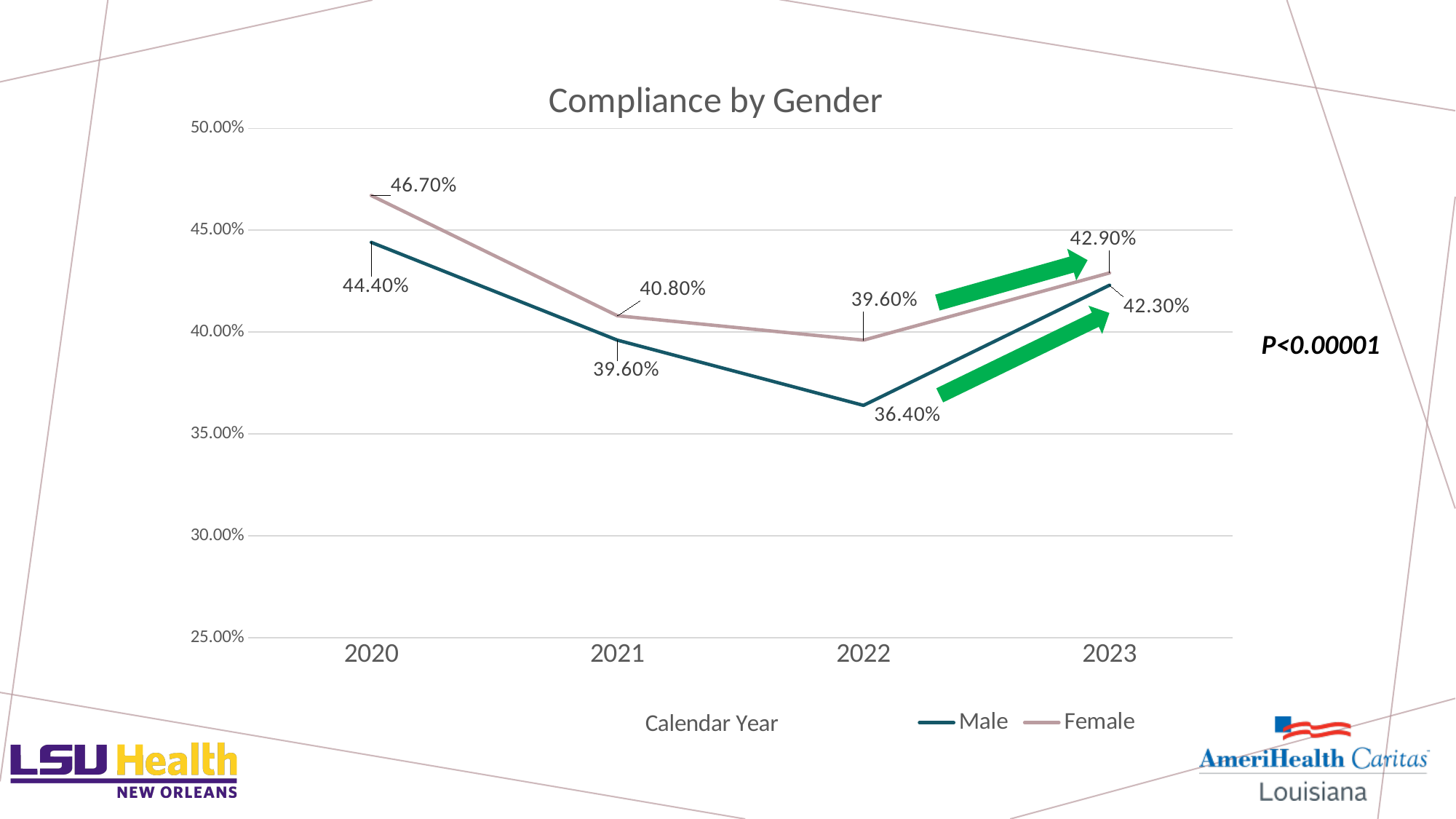
What is the chart's title? Compliance by Gender In which year is the Female series highest? 2020 How many series does the legend list? 2 How many years are plotted on the x axis? 4 What type of chart is shown? line chart In which year is the Male series lowest? 2022 Which is larger in 2021, the Male value or the Female value? Female What is the difference between the Female and Male values in 2022? 3.20% Does the Male series rise or fall from 2020 to 2022? fall What is the Female compliance value for 2020? 46.70% What is the Male compliance value for 2022? 36.40% What is the Male compliance value for 2023? 42.30%